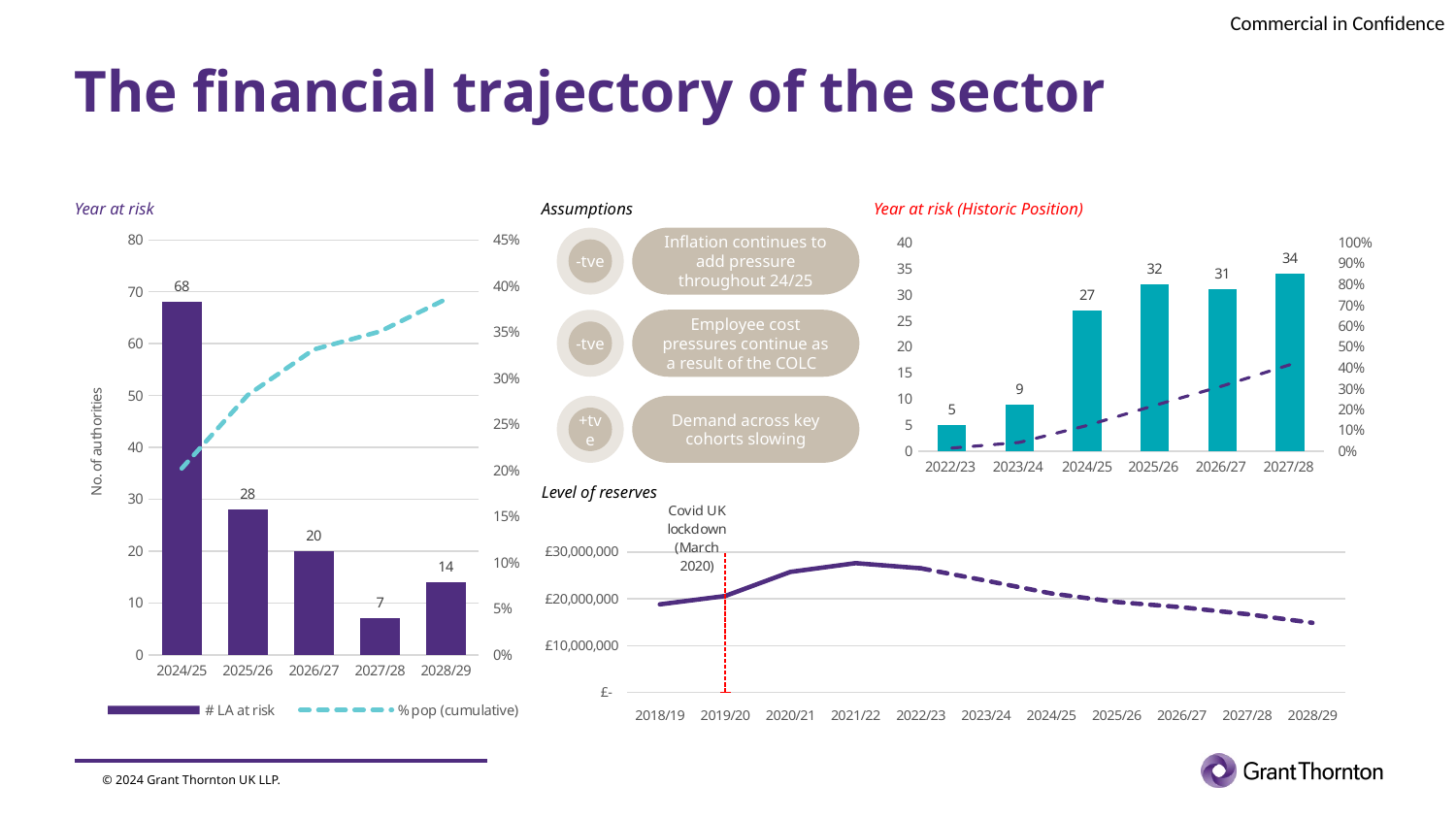
In the 'Year at risk' chart, how many years are shown on the x axis? 5 In the 'Year at risk' chart, which year has the lowest number of LAs at risk? 2027/28 In the 'Year at risk (Historic Position)' chart, which is larger, the value for 2025/26 or 2026/27? 2025/26 In the 'Year at risk (Historic Position)' chart, what is the value for 2024/25? 27 In the 'Year at risk (Historic Position)' chart, what is the difference between the values for 2023/24 and 2022/23? 4 In the 'Year at risk' chart, is the cumulative % pop value for 2028/29 greater or less than 35%? greater In the 'Level of reserves' chart, do the values rise or fall from 2021/22 to 2028/29? fall In the 'Year at risk' chart, how many series does the legend list? 2 In the 'Level of reserves' chart, is the value for 2021/22 greater or less than £30,000,000? less In the 'Year at risk' chart, what is the difference between the number of LAs at risk in 2025/26 and 2026/27? 8 In the 'Year at risk' chart, how many local authorities are at risk in 2024/25? 68 In the 'Year at risk (Historic Position)' chart, which year has the highest bar? 2027/28